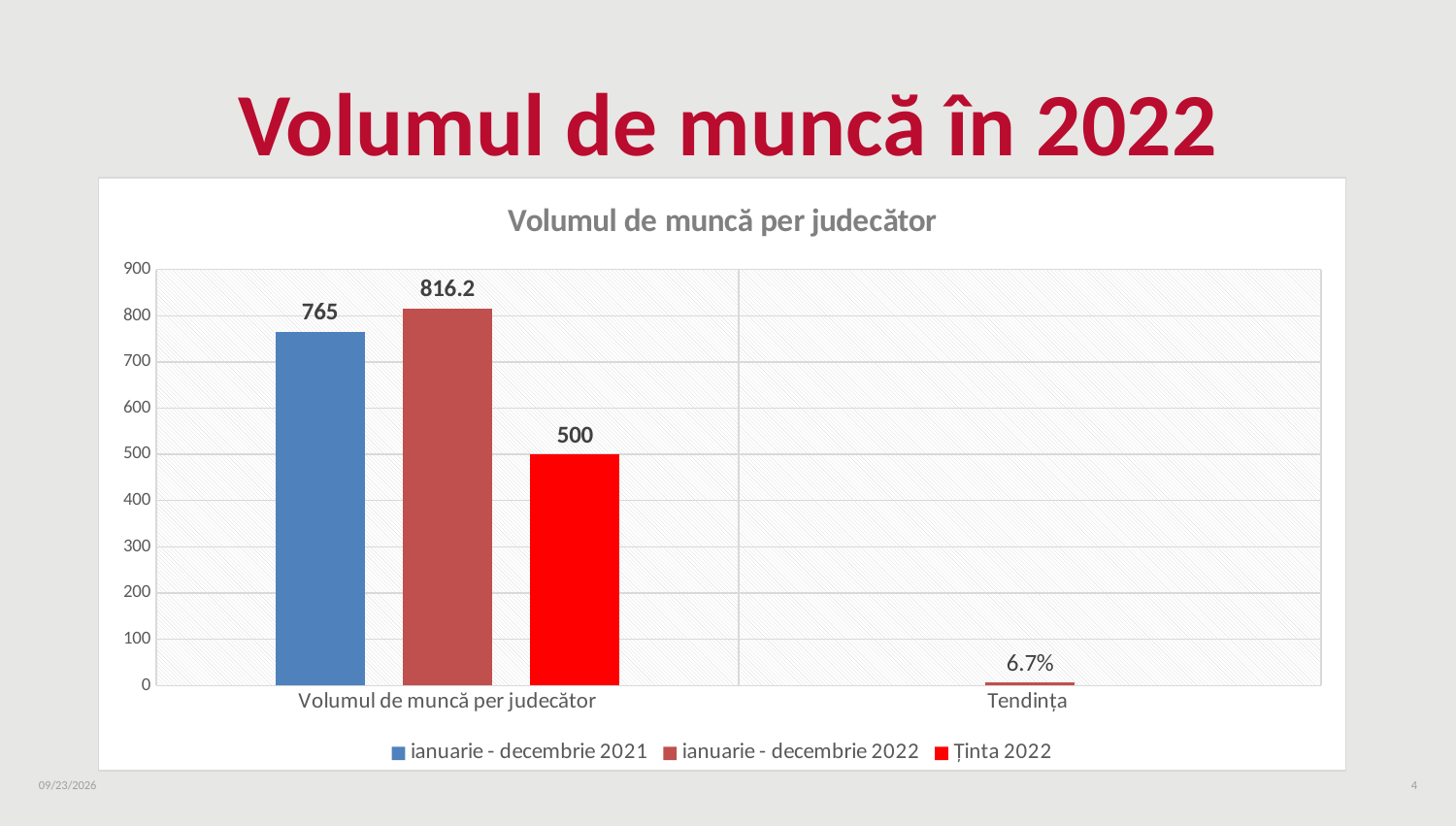
What is the value for 'ianuarie - decembrie 2022' in the 'Volumul de muncă per judecător' category? 816.2 What kind of chart is shown on the slide? Bar chart Which series has the highest value in the 'Volumul de muncă per judecător' category? ianuarie - decembrie 2022 Which is larger: the 'ianuarie - decembrie 2021' value or the 'Ținta 2022' value? ianuarie - decembrie 2021 What is the title of the chart? Volumul de muncă per judecător What value is labelled for the 'Tendința' category? 6.7% What is the difference between the 'ianuarie - decembrie 2022' value and the 'ianuarie - decembrie 2021' value in the 'Volumul de muncă per judecător' category? 51.2 What is the value for 'ianuarie - decembrie 2021' in the 'Volumul de muncă per judecător' category? 765 How many series does the legend list? 3 What is the difference between the 'ianuarie - decembrie 2021' value and the 'Ținta 2022' value? 265 What is the value for 'Ținta 2022' in the 'Volumul de muncă per judecător' category? 500 Which series has the lowest value in the 'Volumul de muncă per judecător' category? Ținta 2022